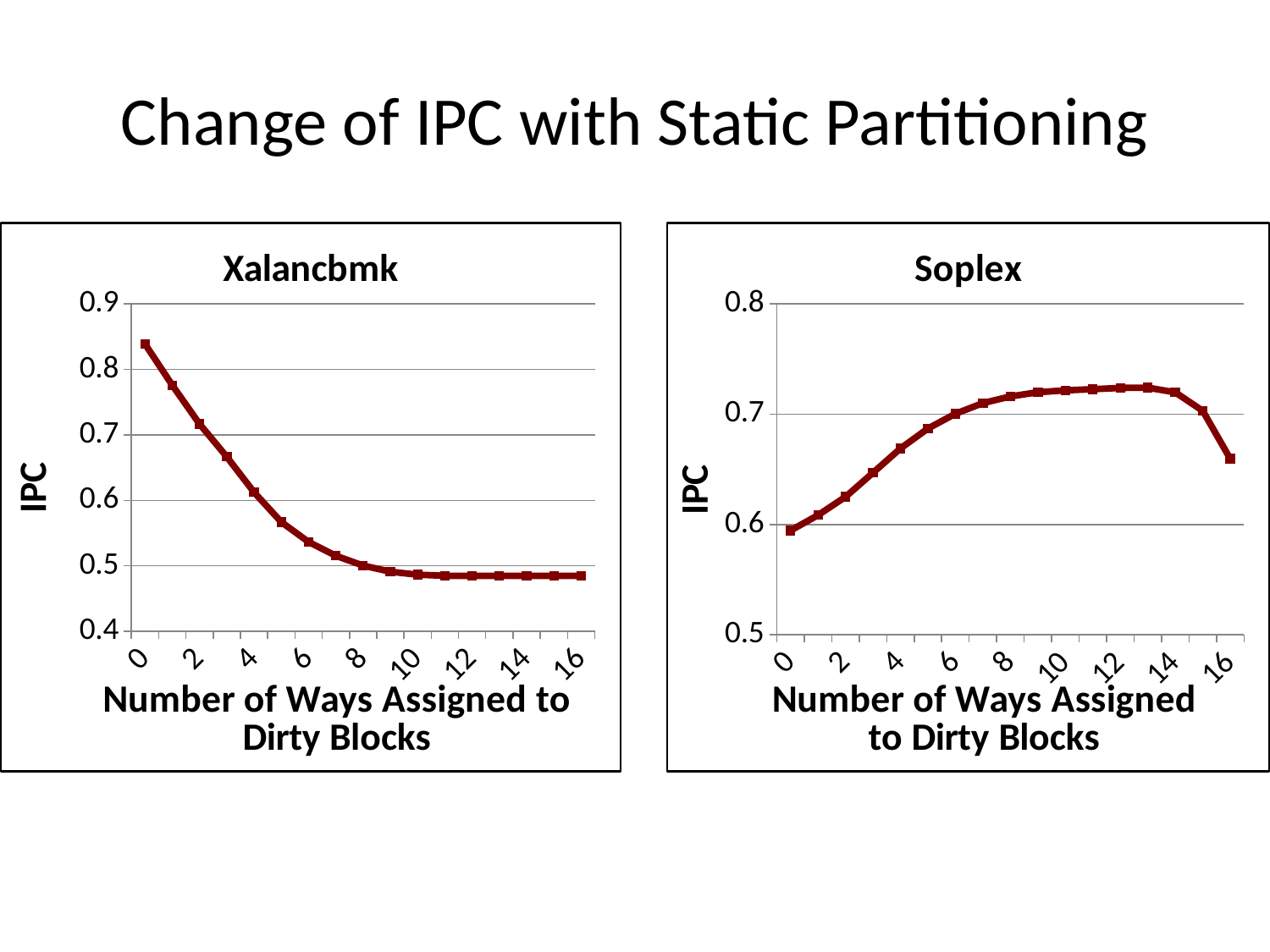
In the Soplex chart, at which number of ways is the IPC lowest? 0 In the Xalancbmk chart, at which number of ways is the IPC highest? 0 In the Soplex chart, is the IPC at 0 ways greater or less than 0.7? less In the Soplex chart, which has the higher IPC: 0 ways or 8 ways? 8 ways In the Xalancbmk chart, is the IPC at 3 ways greater or less than 0.7? less In the Xalancbmk chart, is the IPC at 0 ways greater or less than 0.8? greater What kind of chart is the Xalancbmk chart? line chart What is the y-axis title of the Soplex chart? IPC In the Soplex chart, does IPC rise or fall between 0 and 8 ways assigned to dirty blocks? rise In the Xalancbmk chart, does IPC rise or fall as the number of ways assigned to dirty blocks increases? fall